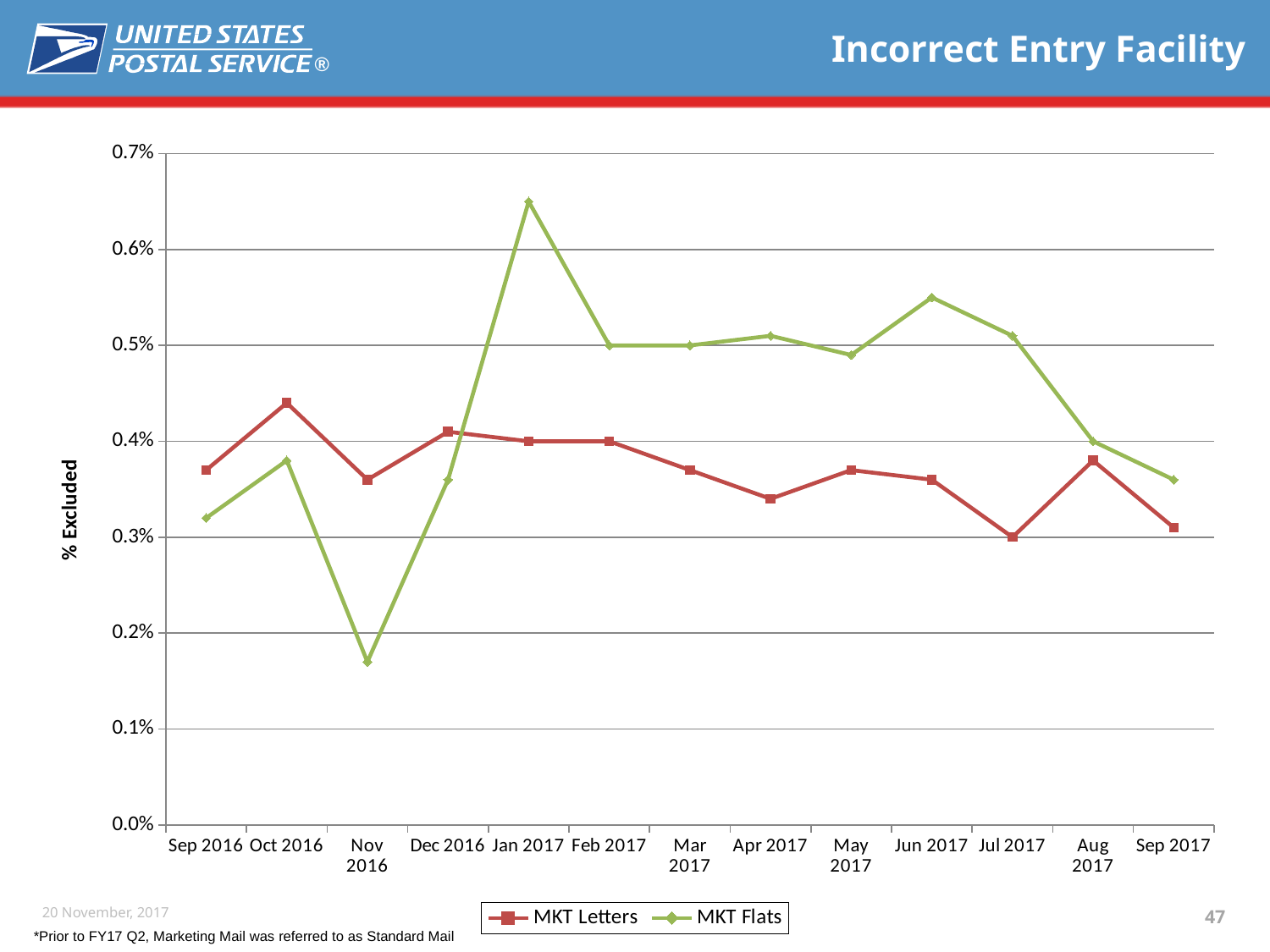
In which month does MKT Flats reach its highest value? Jan 2017 Is the value for MKT Flats in Jan 2017 greater or less than 0.6%? greater How many series does the legend list? 2 Is the value for MKT Letters in Apr 2017 greater or less than 0.4%? less Does the MKT Flats line rise or fall from Jun 2017 to Sep 2017? fall What is the label on the vertical axis? % Excluded What kind of chart is shown on the slide? line chart How many months are plotted along the x axis? 13 Is the value for MKT Flats in Nov 2016 greater or less than 0.2%? less In which month does MKT Flats reach its lowest value? Nov 2016 In Nov 2016, which series has the larger value, MKT Letters or MKT Flats? MKT Letters In which month does MKT Letters reach its highest value? Oct 2016